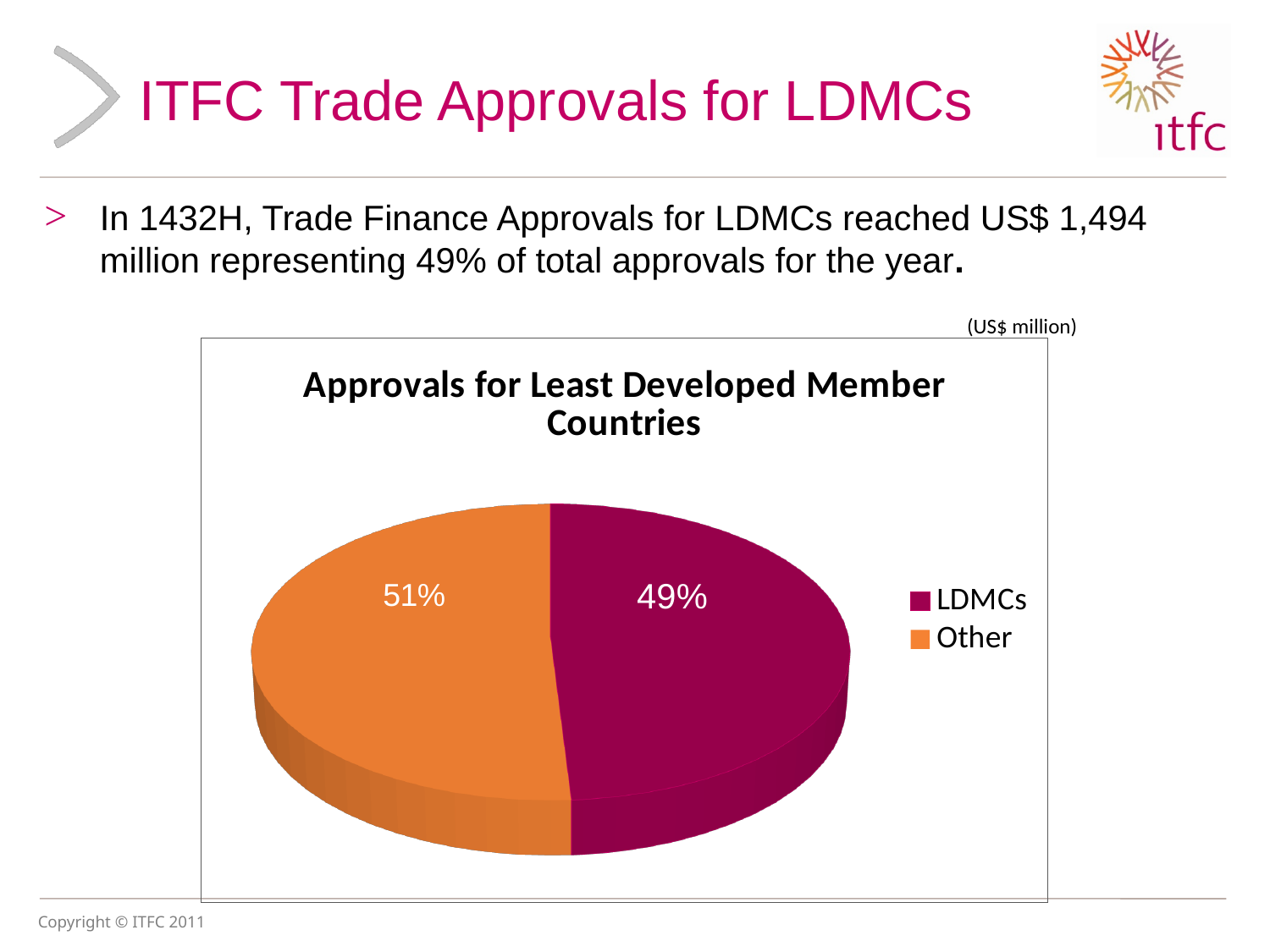
Which slice of the pie is the largest? Other How many slices does the pie chart have? 2 How many entries does the chart legend list? 2 What share of the pie does the LDMCs slice represent? 49% Which is larger, the LDMCs slice or the Other slice? Other What is the difference in percentage points between the Other slice and the LDMCs slice? 2 percentage points What kind of chart is shown on the slide? Pie chart Is the share for LDMCs greater or less than 50%? less What share of the pie does the Other slice represent? 51% Which colour represents LDMCs in the pie chart? Magenta (dark pink) What is the title of the chart? Approvals for Least Developed Member Countries Which slice of the pie is the smallest? LDMCs